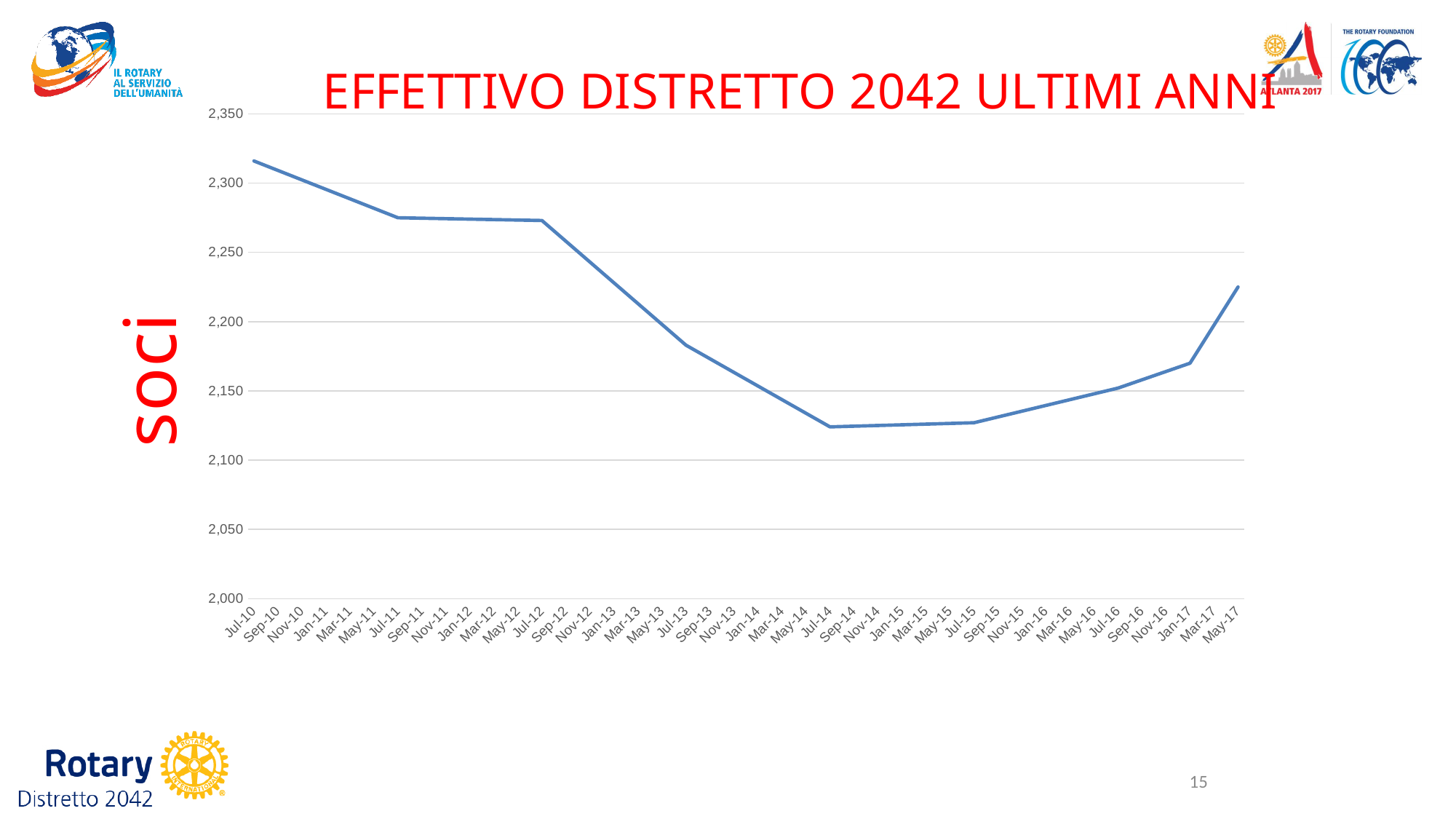
What is the title of the chart? EFFETTIVO DISTRETTO 2042 ULTIMI ANNI At which date does the line reach its highest value? Jul-10 Is the value for Jul-14 greater or less than 2,150? less Is the value for Jul-11 greater or less than 2,250? greater What kind of chart is shown on the slide? Line chart Which is larger, the value for Jul-12 or the value for Jul-13? Jul-12 Is the value for May-17 greater or less than 2,200? greater Do the values rise or fall from Jul-10 to Jul-14? fall What label is shown on the vertical axis of the chart? SOCI Which is larger, the value for Jul-10 or the value for May-17? Jul-10